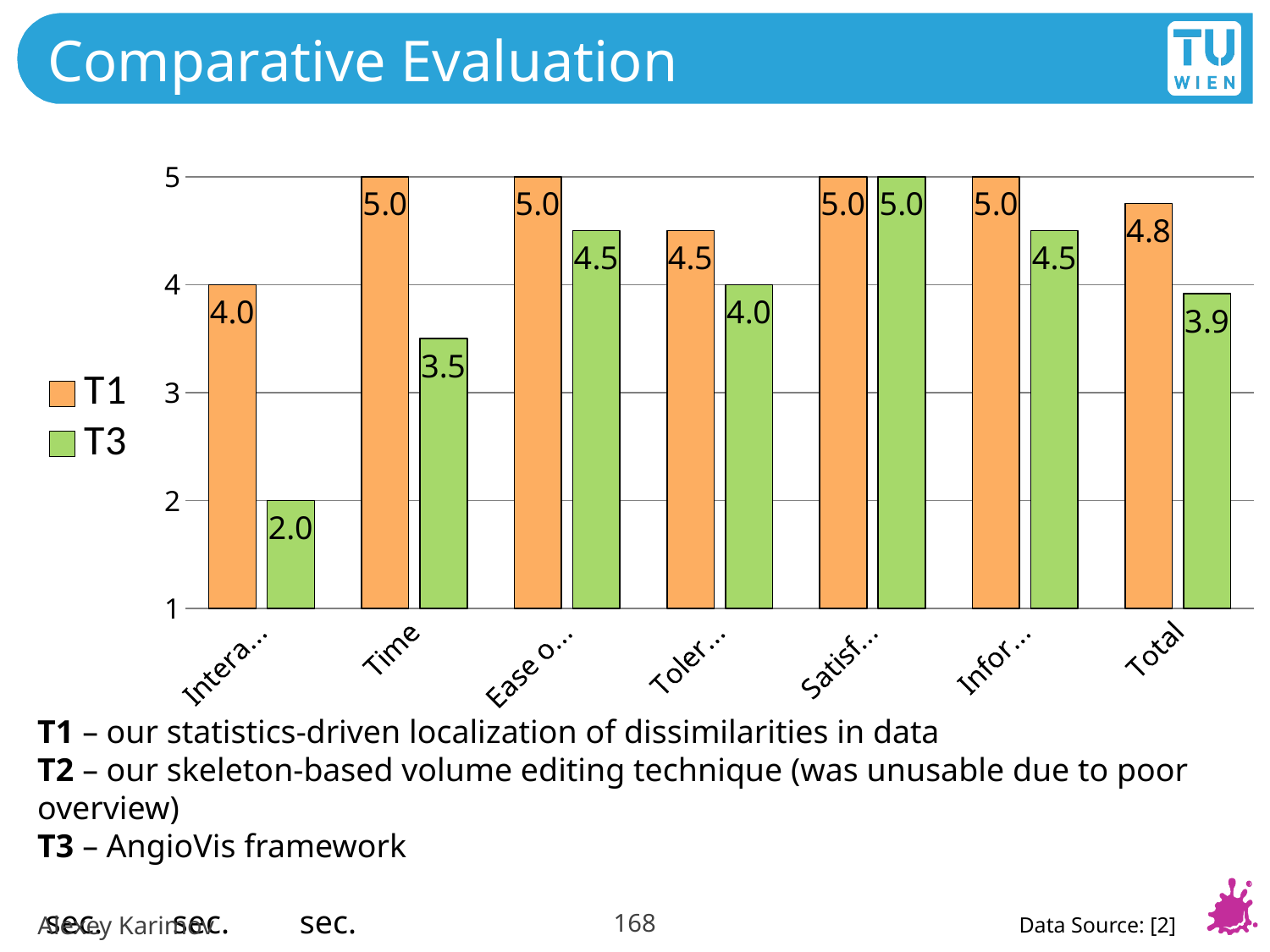
What is the T3 value for Total? 3.9 What is the lowest value shown for the T3 series? 2.0 What is the T1 value for Time? 5.0 What is the difference between the T1 and T3 values for Total? 0.9 What kind of chart is shown on the slide? Bar chart How many categories are shown on the x axis? 7 For Time, which series has the larger value, T1 or T3? T1 What is the difference between the T1 and T3 values for Time? 1.5 What is the T1 value for Total? 4.8 How many series does the legend list? 2 What is the T3 value for Time? 3.5 For Total, which series has the larger value, T1 or T3? T1